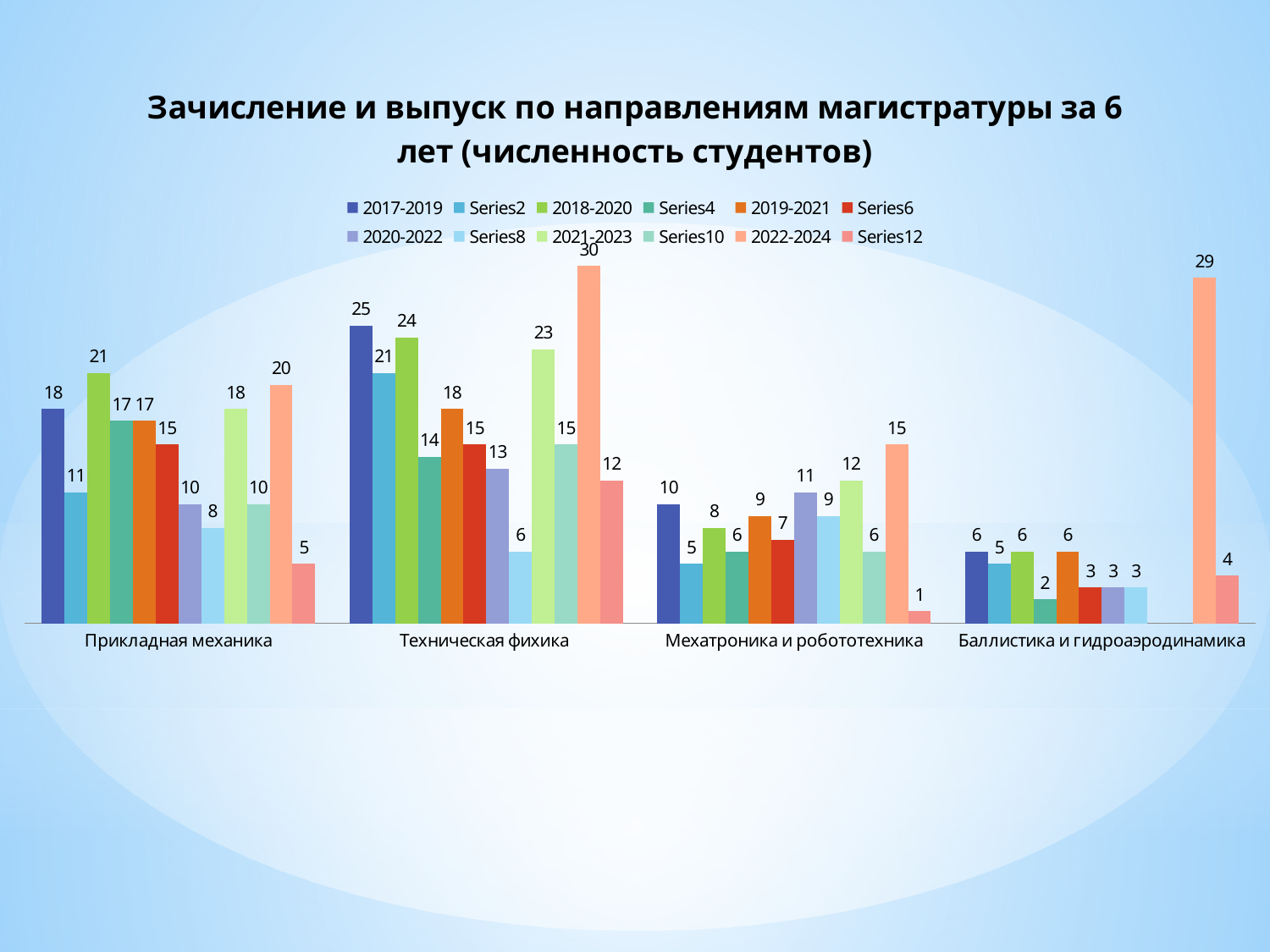
Which category has the larger 2018-2020 value, Прикладная механика or Техническая фихика? Техническая фихика What is the value for Series12 in the Мехатроника и робототехника category? 1 What kind of chart is shown on the slide? bar chart What is the value for 2022-2024 in the Баллистика и гидроаэродинамика category? 29 Which category has the lowest value for the 2017-2019 series? Баллистика и гидроаэродинамика How many series does the legend list? 12 What is the value for 2017-2019 in the Прикладная механика category? 18 How many categories are shown on the x axis? 4 What is the title of the chart? Зачисление и выпуск по направлениям магистратуры за 6 лет (численность студентов) Which category has the highest value for the 2022-2024 series? Техническая фихика What is the value for 2022-2024 in the Техническая фихика category? 30 What is the difference between the 2022-2024 values for Техническая фихика and Прикладная механика? 10